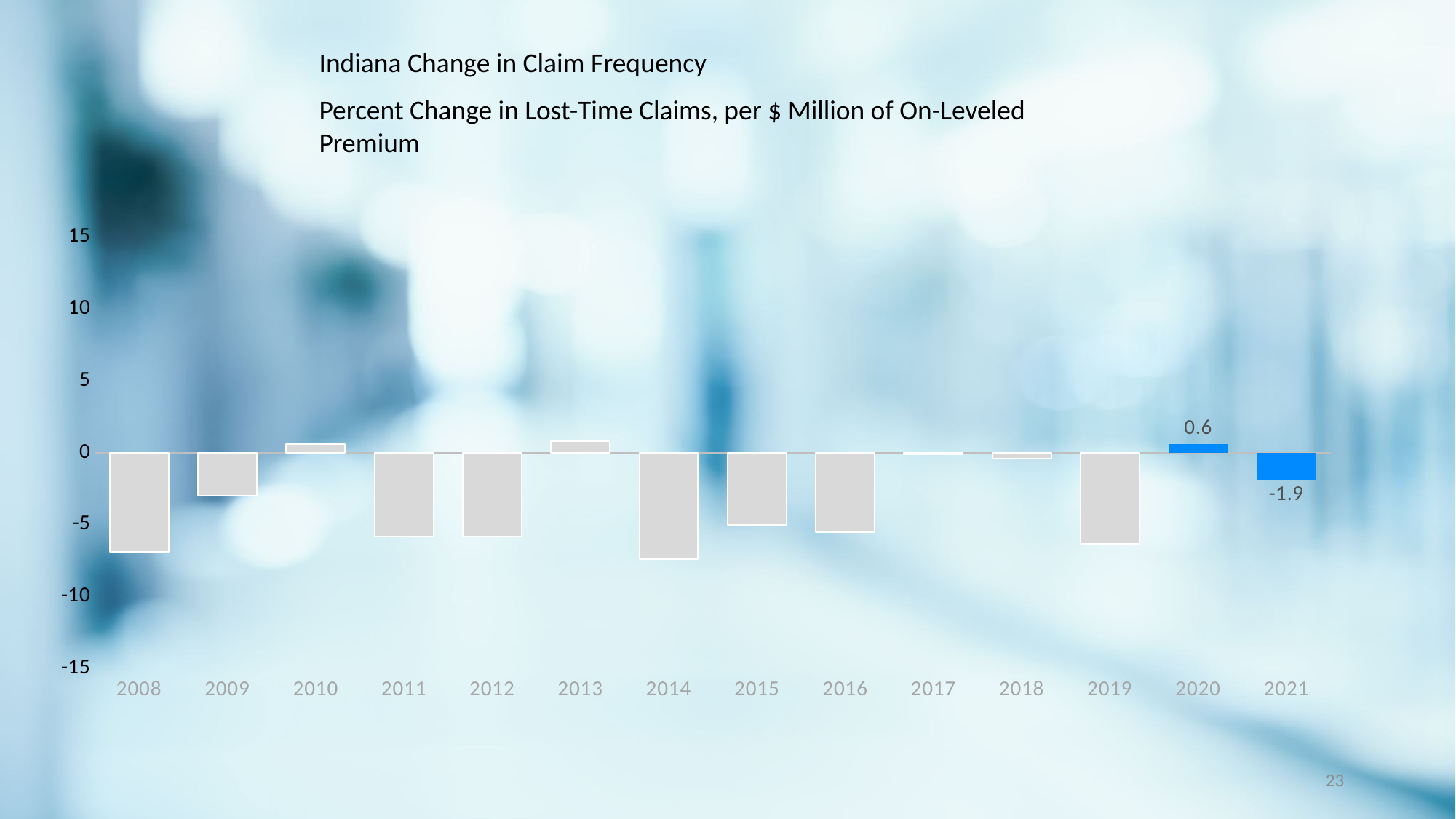
Is the value for 2014 greater or less than -5? less What is the value for 2021? -1.9 Which is larger, the value for 2008 or the value for 2009? 2009 Is the value for 2019 greater or less than -5? less What kind of chart is shown on the slide? bar chart Which is larger, the value for 2020 or the value for 2021? 2020 Which years are shown with blue bars? 2020 and 2021 What is the difference between the values for 2020 and 2021? 2.5 Is the value for 2008 greater or less than -5? less What is the value for 2020? 0.6 How many years are shown on the x axis? 14